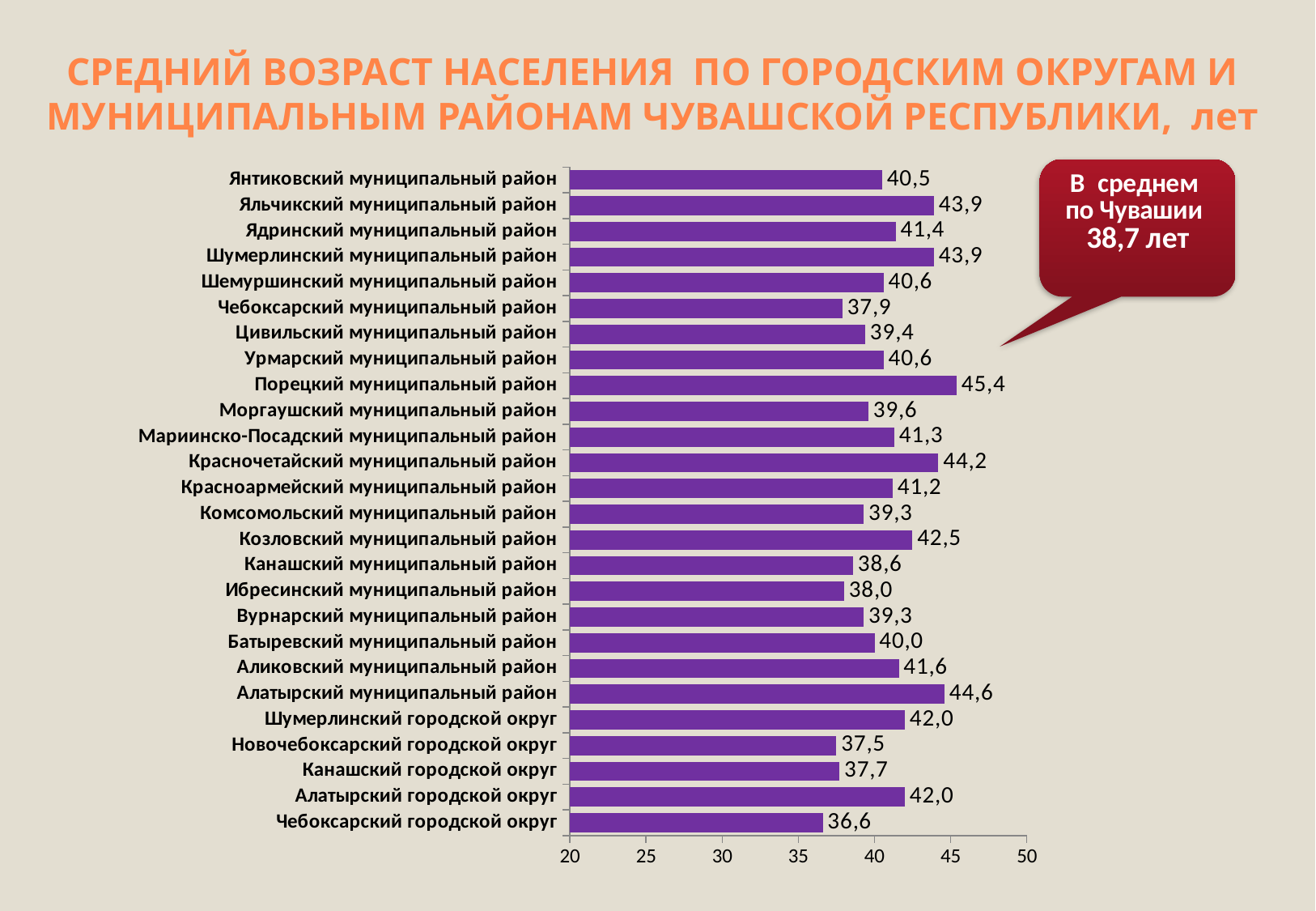
Which category has the lowest average age? Чебоксарский городской округ Which category has the highest average age? Порецкий муниципальный район What kind of chart is shown on the slide? bar chart What is the average age for Новочебоксарский городской округ? 37,5 What is the difference between the average age of Алатырский муниципальный район and Алатырский городской округ? 2,6 Is the value for Канашский городской округ greater or less than 40? less How many categories are shown in the chart? 26 Which has a higher average age, Красночетайский муниципальный район or Козловский муниципальный район? Красночетайский муниципальный район What is the average age for Порецкий муниципальный район? 45,4 What colour are the bars in the chart? purple What is the average age for Чебоксарский городской округ? 36,6 What is the average age for Chuvashia as a whole, according to the callout on the slide? 38,7 лет